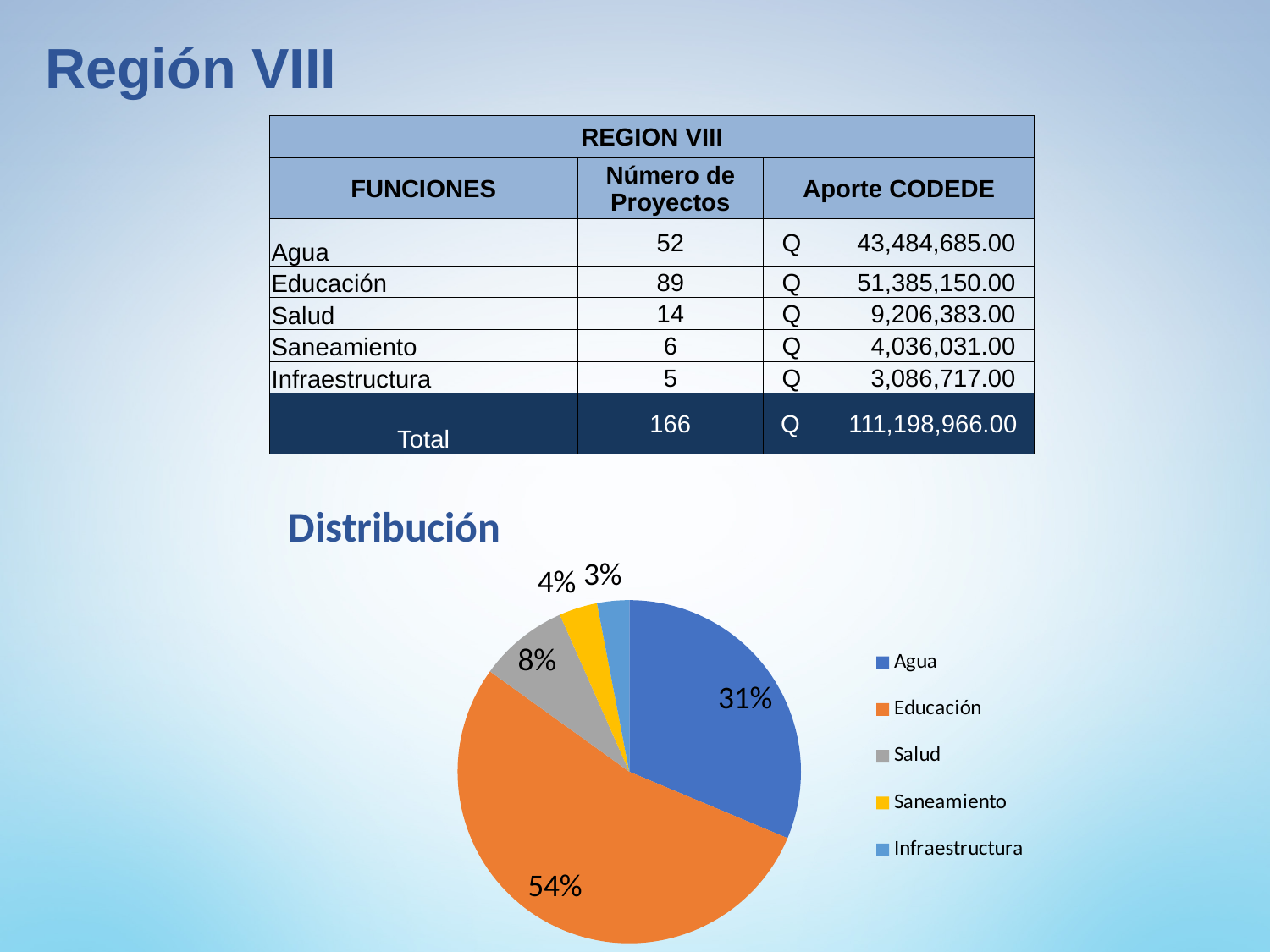
In the "Distribución" pie chart, what percentage is shown for Saneamiento? 4% In the "Distribución" pie chart, which slice is larger, Salud or Saneamiento? Salud Which category has the smallest slice in the "Distribución" pie chart? Infraestructura What kind of chart is shown under the title "Distribución"? pie chart In the "Distribución" pie chart, what is the difference in percentage points between Educación and Agua? 23 In the "Distribución" pie chart, what percentage is shown for Salud? 8% In the "Distribución" pie chart, what percentage is shown for Agua? 31% How many slices does the "Distribución" pie chart have? 5 What colour is the Educación slice in the "Distribución" pie chart? orange Which category has the largest slice in the "Distribución" pie chart? Educación In the "Distribución" pie chart, what percentage is shown for Educación? 54% In the "Distribución" pie chart, what percentage is shown for Infraestructura? 3%